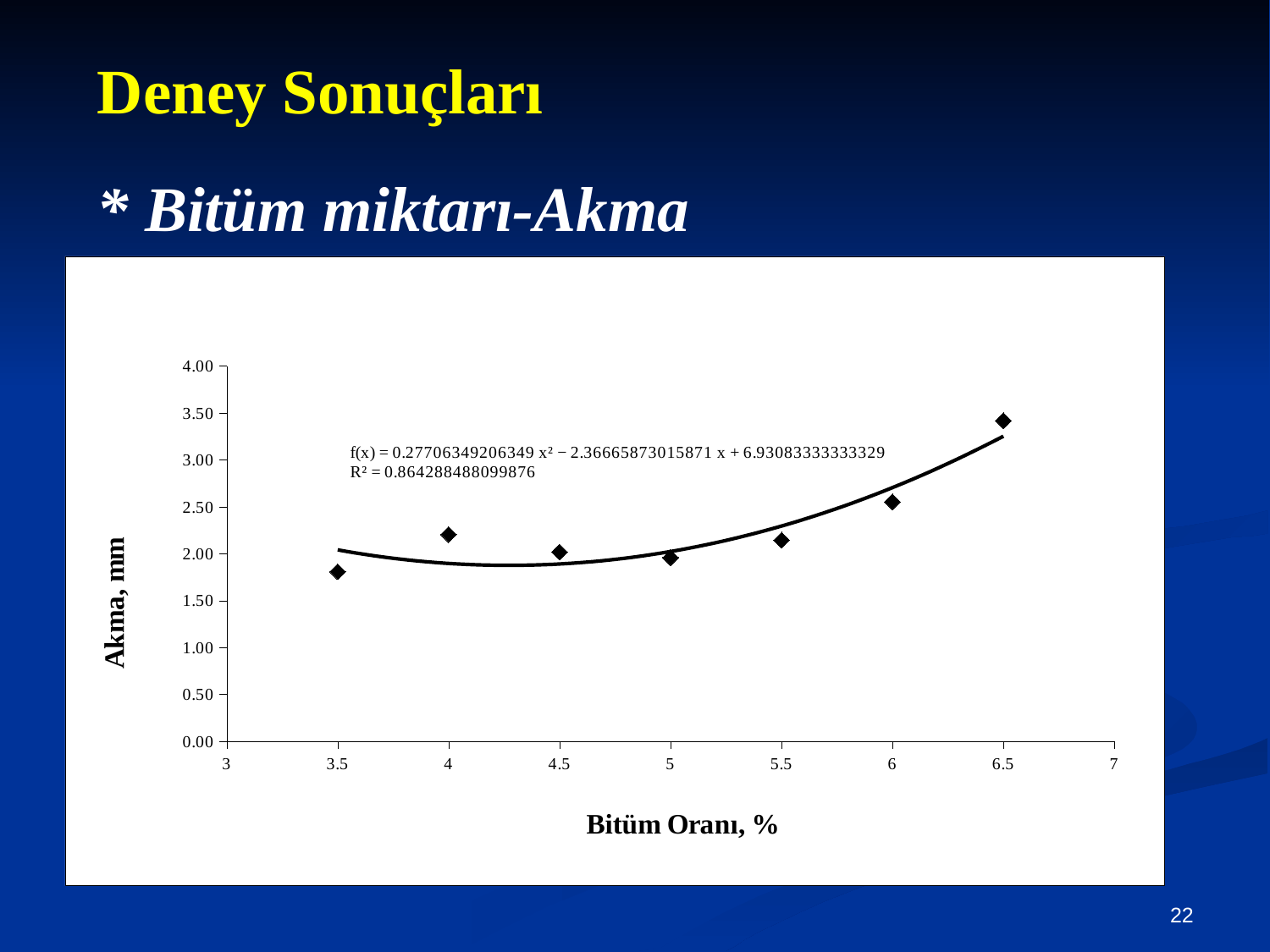
Is the Akma value at Bitüm Oranı 4 greater or less than 2.00? greater Do the Akma values rise or fall as Bitüm Oranı increases from 5 to 6.5? rise What is the title of the vertical axis? Akma, mm How many data points are plotted on the chart? 7 What R² value is shown for the trendline on the chart? 0.864288488099876 At which Bitüm Oranı value is Akma the lowest? 3.5 At which Bitüm Oranı value is Akma the highest? 6.5 What kind of chart is shown on the slide? Scatter chart Is the Akma value at Bitüm Oranı 6 greater or less than 3.00? less Is the Akma value at Bitüm Oranı 6.5 greater or less than 3.00? greater Which has a higher Akma value: Bitüm Oranı 6 or Bitüm Oranı 4? 6